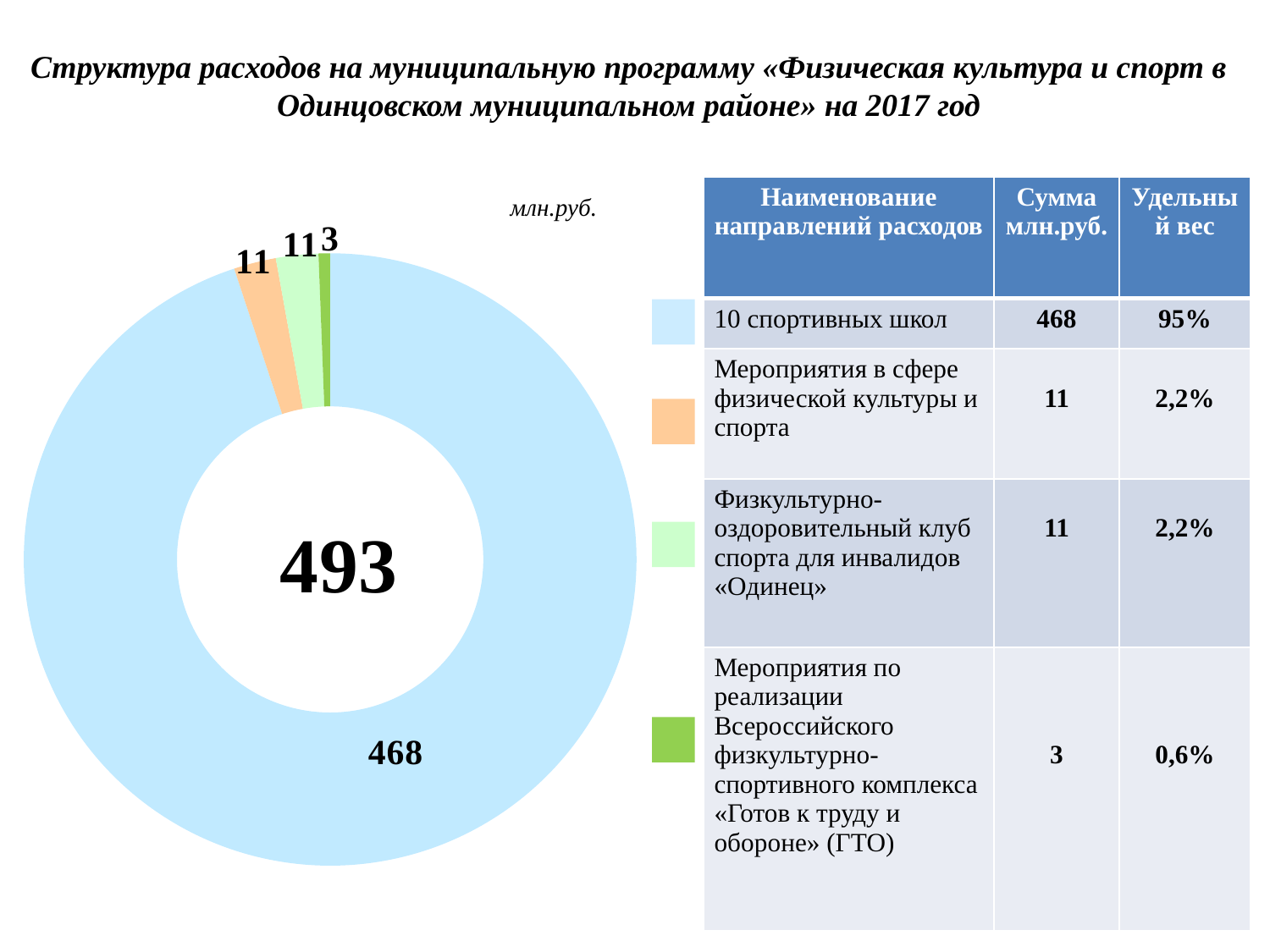
How many slices does the doughnut chart have? 4 What share of the total does «10 спортивных школ» account for, according to the table? 95% Which category has the smallest slice in the chart? Мероприятия по реализации Всероссийского физкультурно-спортивного комплекса «Готов к труду и обороне» (ГТО) What share of the total does the ГТО category account for, according to the table? 0,6% What is the value shown for «10 спортивных школ» in the chart? 468 Which category has the largest slice in the chart? 10 спортивных школ What is the value shown for «Мероприятия по реализации Всероссийского физкультурно-спортивного комплекса «Готов к труду и обороне» (ГТО)»? 3 Which is larger: the value for «10 спортивных школ» or the value for «Мероприятия в сфере физической культуры и спорта»? 10 спортивных школ In what units are the chart values given? млн.руб. What kind of chart is shown on the slide? doughnut (pie) chart What is the difference between the value for «10 спортивных школ» and the value for the ГТО category? 465 What total value is printed in the centre of the doughnut chart? 493